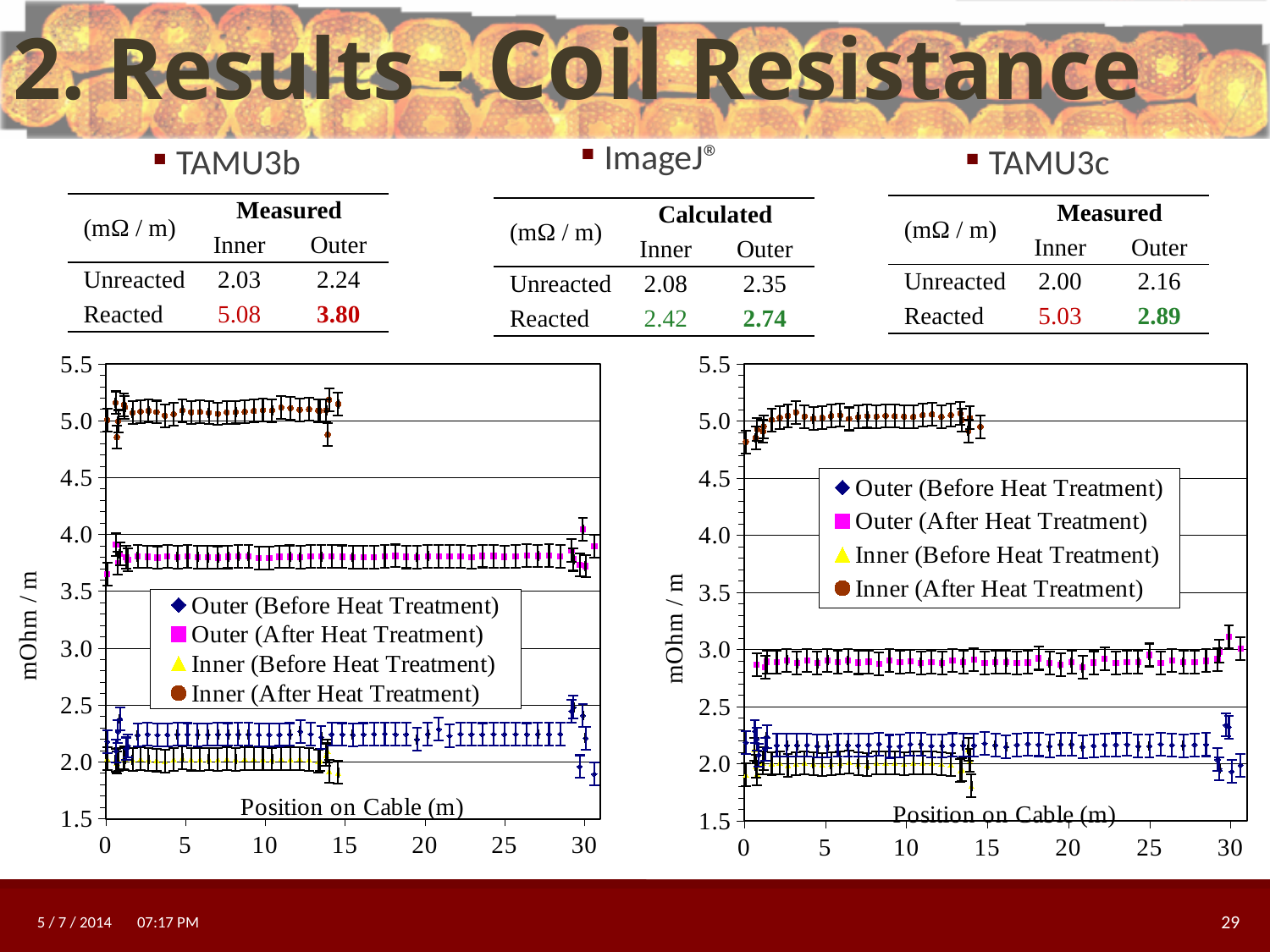
In the left chart, which series has larger values: Inner (After Heat Treatment) or Outer (After Heat Treatment)? Inner (After Heat Treatment) In the right chart, which series has larger values: Outer (After Heat Treatment) or Outer (Before Heat Treatment)? Outer (After Heat Treatment) How many series does the legend of the left chart list? 4 In the left chart, which series has the highest values? Inner (After Heat Treatment) In the right chart, are the values for Outer (Before Heat Treatment) greater or less than 2.5? less In the right chart, are the values for Outer (After Heat Treatment) greater or less than 2.5? greater In the left chart, are the values for Outer (After Heat Treatment) greater or less than 3.5? greater How many series does the legend of the right chart list? 4 What kind of chart is the left chart on the slide? scatter chart In the right chart, which series has the highest values? Inner (After Heat Treatment) What is the x-axis label of the right chart? Position on Cable (m)